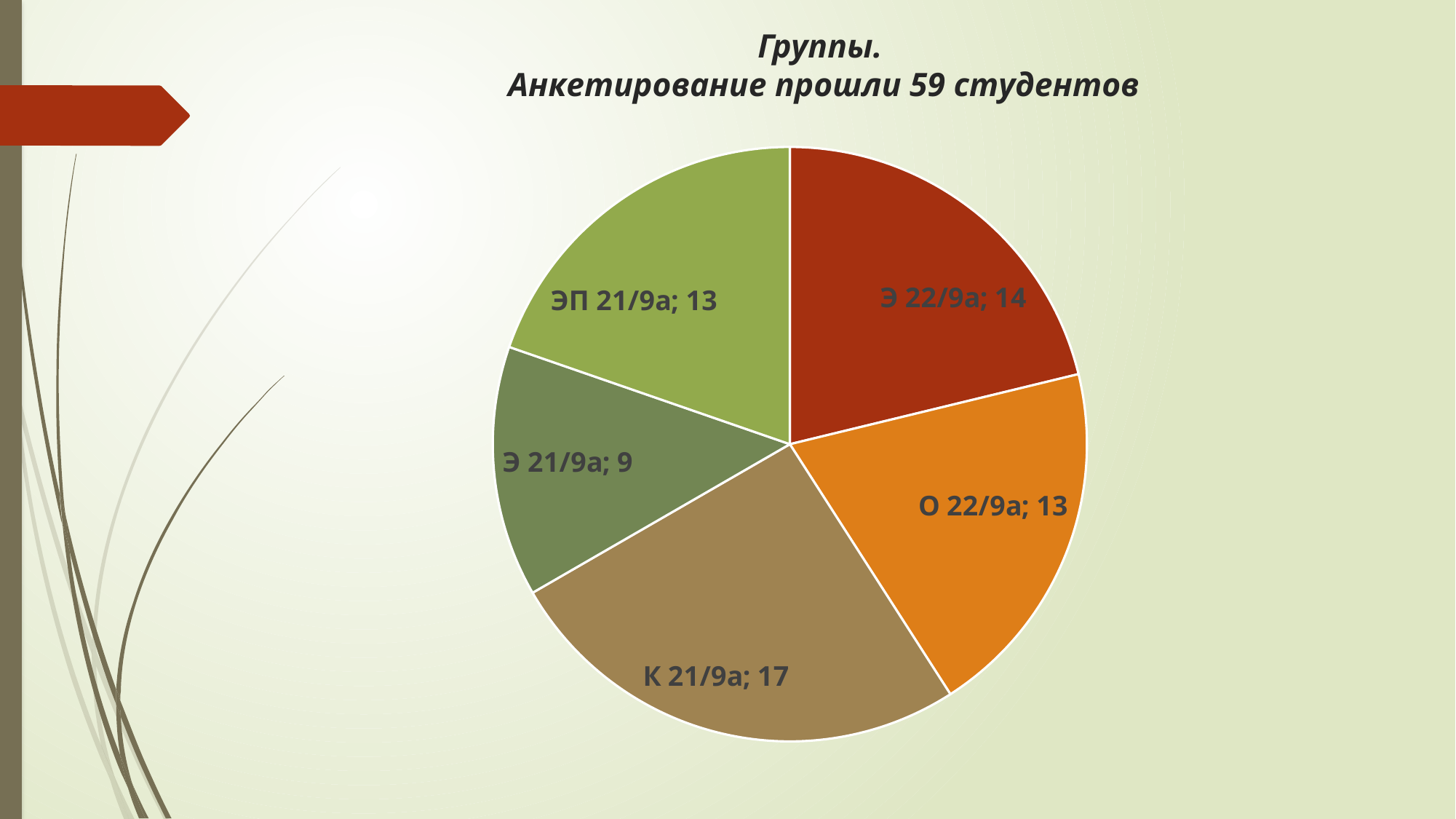
What is the sum of all the slice values shown on the pie chart? 66 What is the value for the slice labelled О 22/9а? 13 What is the value for the slice labelled К 21/9а? 17 How many slices does the pie chart have? 5 What is the difference between the values for К 21/9а and Э 21/9а? 8 Which is larger, the value for Э 22/9а or the value for Э 21/9а? Э 22/9а Which group has the largest slice of the pie? К 21/9а What is the title of the chart? Группы. Анкетирование прошли 59 студентов Which group has the smallest slice of the pie? Э 21/9а What is the value for the slice labelled Э 21/9а? 9 What kind of chart is shown on the slide? pie chart What is the value for the slice labelled Э 22/9а? 14